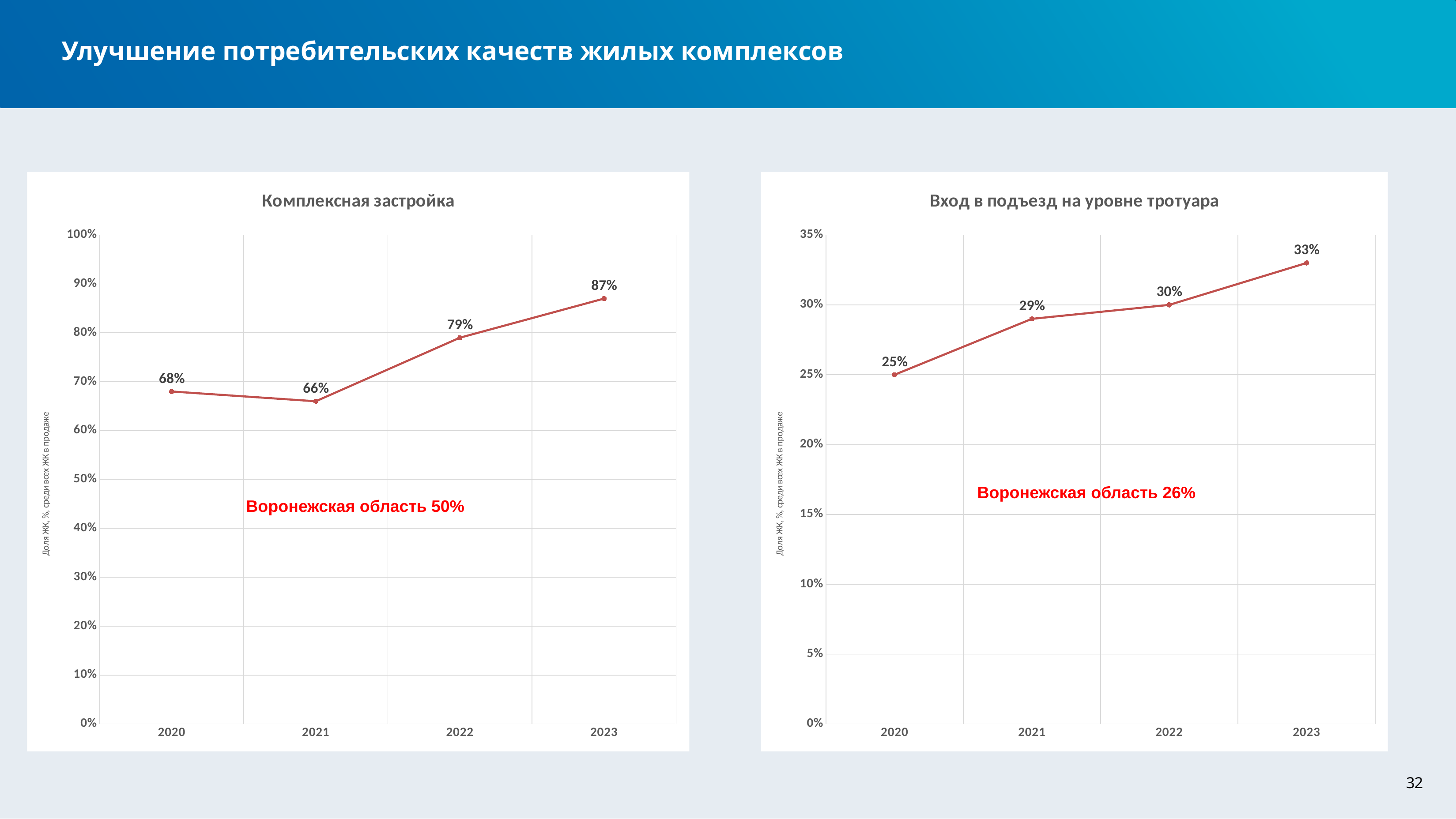
In the chart titled "Вход в подъезд на уровне тротуара", which is larger, the value for 2020 or the value for 2022? 2022 In the chart titled "Комплексная застройка", what value is given for Воронежская область in the red annotation? 50% In the chart titled "Вход в подъезд на уровне тротуара", do the values rise or fall from 2020 to 2023? Rise In the chart titled "Комплексная застройка", what kind of chart is shown? Line chart In the chart titled "Комплексная застройка", what is the value for 2022? 79% In the chart titled "Вход в подъезд на уровне тротуара", which year has the highest value? 2023 In the chart titled "Вход в подъезд на уровне тротуара", what is the difference between the 2023 and 2020 values? 8% In the chart titled "Вход в подъезд на уровне тротуара", what is the maximum value shown on the y axis? 35% In the chart titled "Комплексная застройка", which year has the lowest value? 2021 In the chart titled "Комплексная застройка", what is the difference between the 2023 and 2020 values? 19% In the chart titled "Комплексная застройка", how many years are plotted on the x axis? 4 In the chart titled "Вход в подъезд на уровне тротуара", what is the value for 2021? 29%